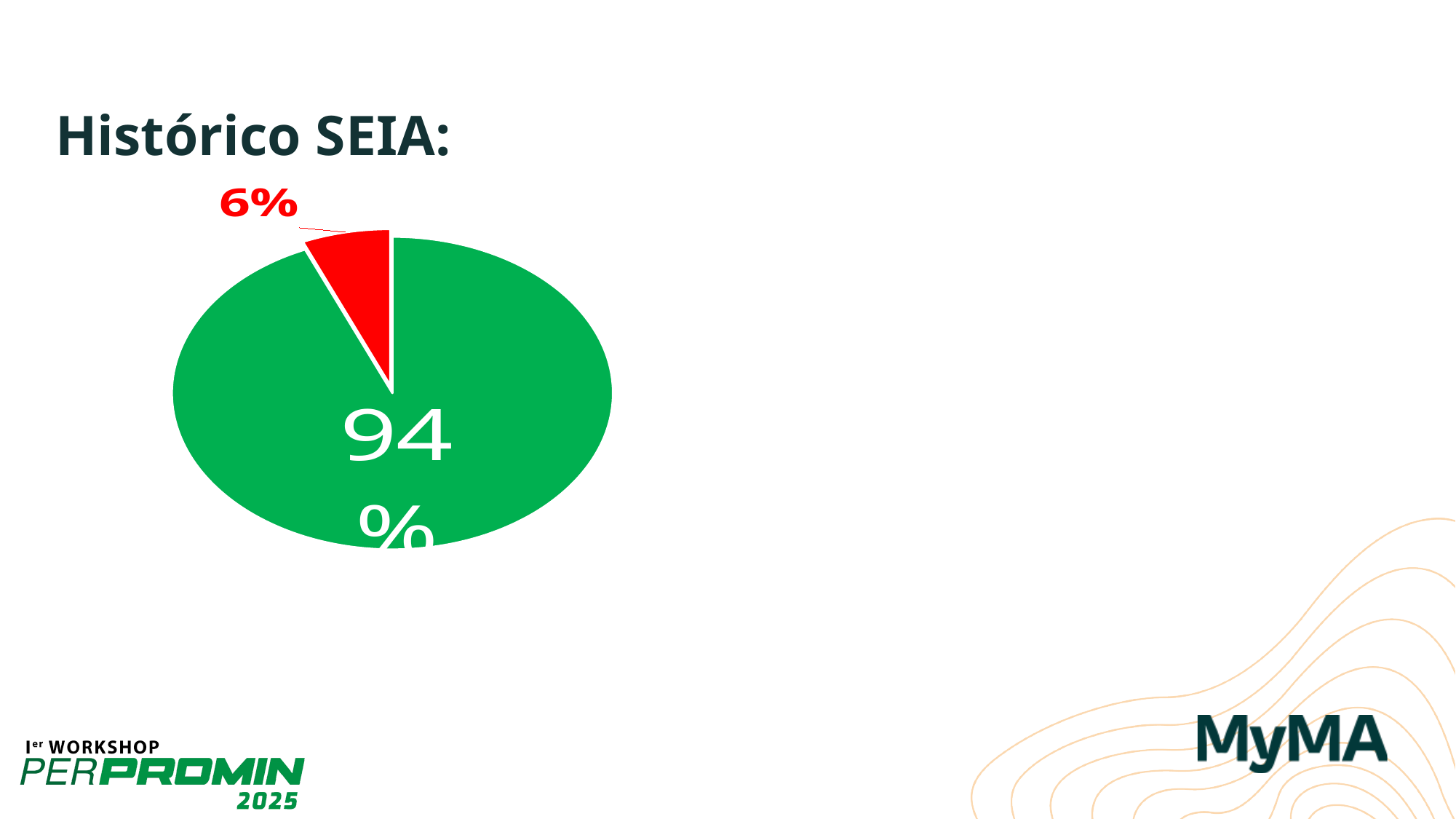
Which slice of the pie chart is the largest? the green slice (94%) What do the two slices of the pie chart add up to? 100% How many slices does the pie chart have? 2 What percentage is shown for the red slice of the pie chart? 6% What is the title shown above the pie chart? Histórico SEIA: Which is larger, the green slice or the red slice? the green slice What percentage is shown on the green slice of the pie chart? 94% Which slice of the pie chart is the smallest? the red slice (6%) What kind of chart is shown on the slide? pie chart What is the difference in percentage points between the green slice and the red slice? 88 What colour is the slice labelled 6%? red